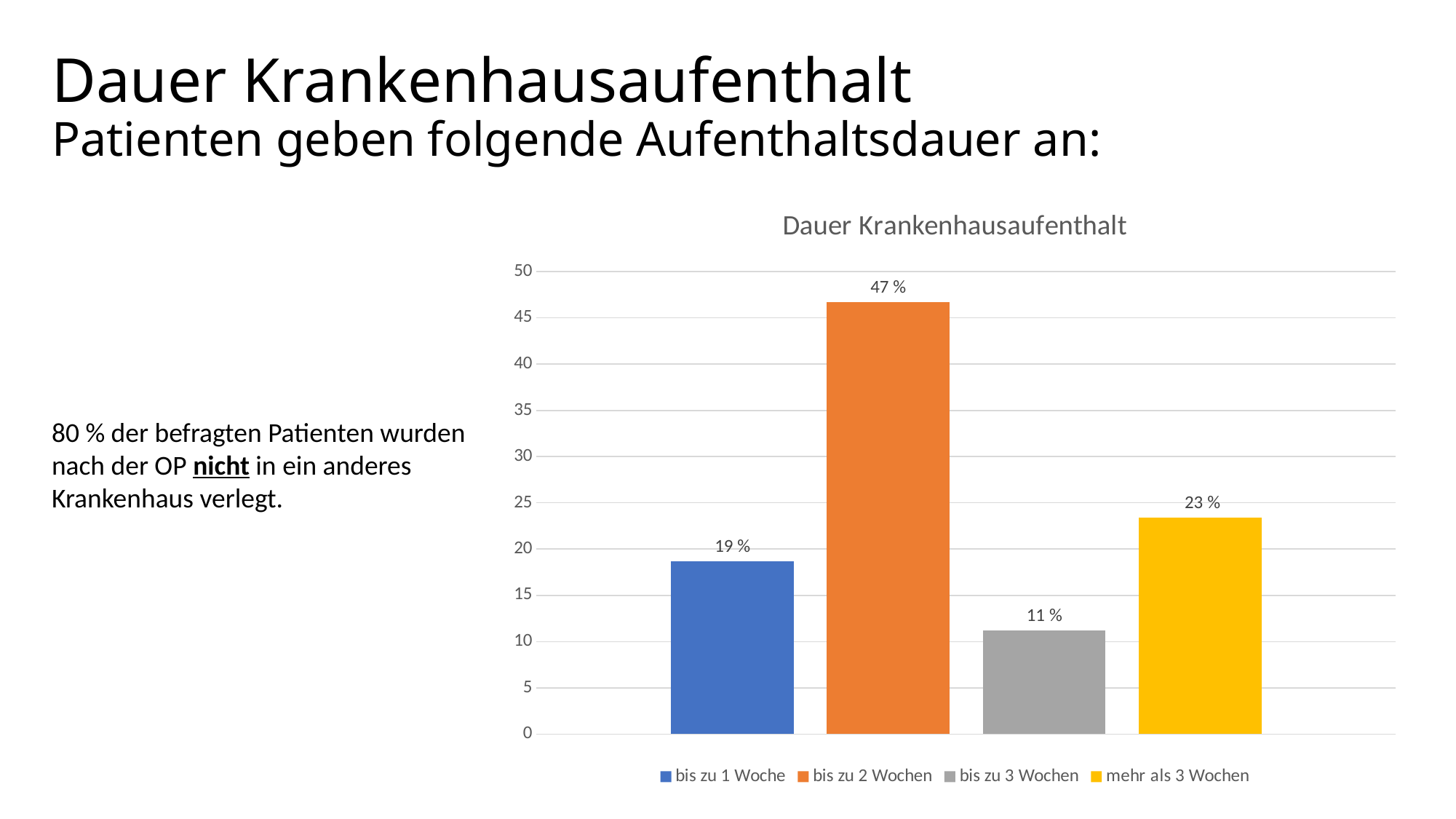
Which is larger, the value for 'mehr als 3 Wochen' or the value for 'bis zu 1 Woche'? mehr als 3 Wochen How many entries does the legend list? 4 Is the value for 'bis zu 3 Wochen' greater or less than 15? less What is the value for 'bis zu 1 Woche'? 19 % What kind of chart is shown on the slide? bar chart What is the difference between the values for 'bis zu 2 Wochen' and 'bis zu 1 Woche'? 28 % What is the title of the chart? Dauer Krankenhausaufenthalt What is the value for 'mehr als 3 Wochen'? 23 % Which category has the lowest value? bis zu 3 Wochen Which category has the highest value? bis zu 2 Wochen How many bars are shown in the chart? 4 What is the value for 'bis zu 2 Wochen'? 47 %